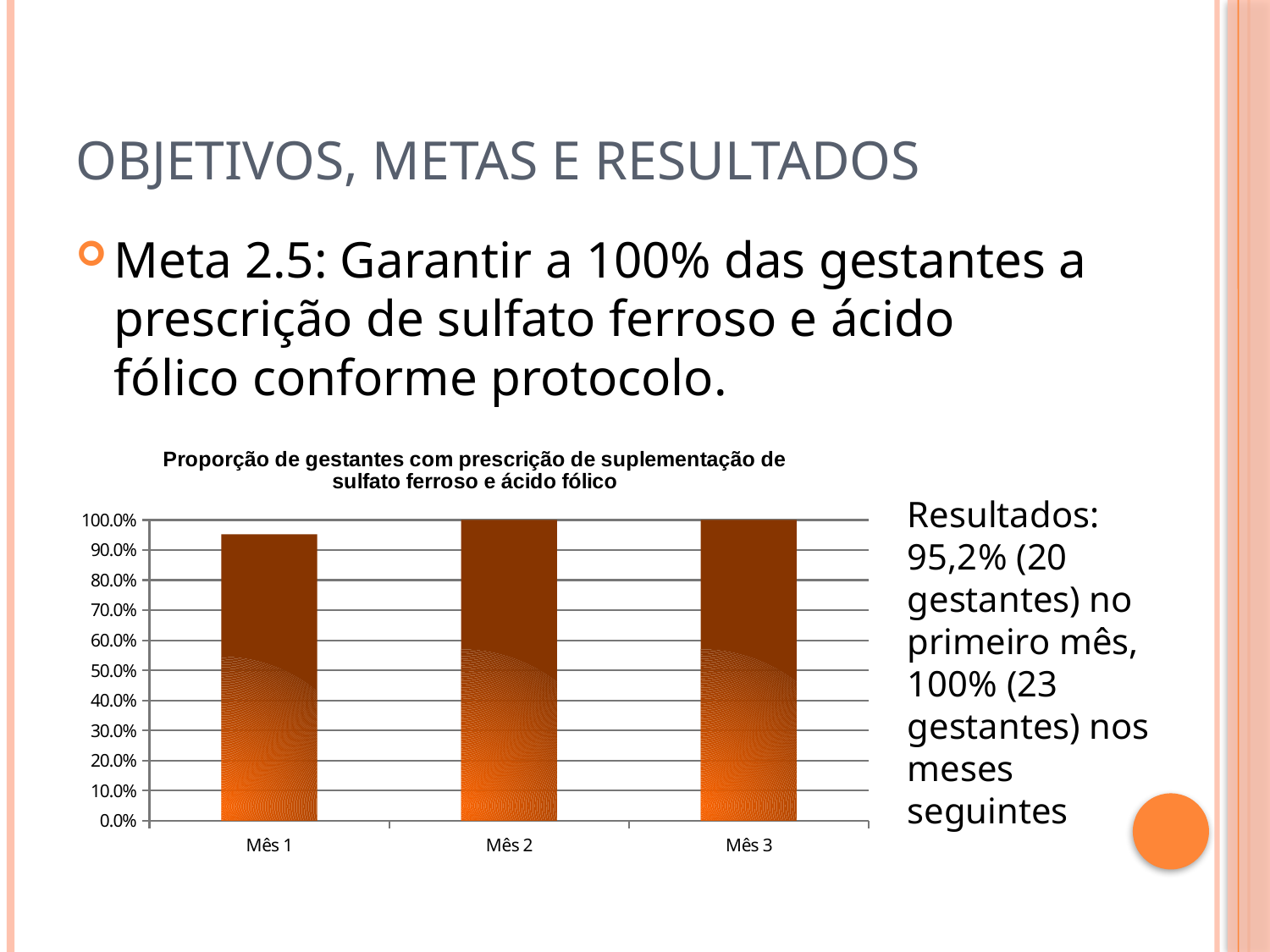
What kind of chart is shown on the slide? Bar chart What is the highest value shown on the chart's y axis? 100.0% According to the slide, what proportion of pregnant women received the prescription in the first month (Mês 1)? 95,2% Do the values rise or fall from Mês 1 to Mês 2? Rise What is the value for Mês 3 in the chart? 100.0% Which month has the lowest value in the chart? Mês 1 What is the value for Mês 2 in the chart? 100.0% How many months (categories) are plotted on the x axis of the chart? 3 Is the value for Mês 1 greater or less than 90.0%? greater Which is larger, the value for Mês 1 or the value for Mês 2? Mês 2 What is the title of the chart? Proporção de gestantes com prescrição de suplementação de sulfato ferroso e ácido fólico What is the difference between the value for Mês 2 and the value for Mês 1? 4,8 percentage points